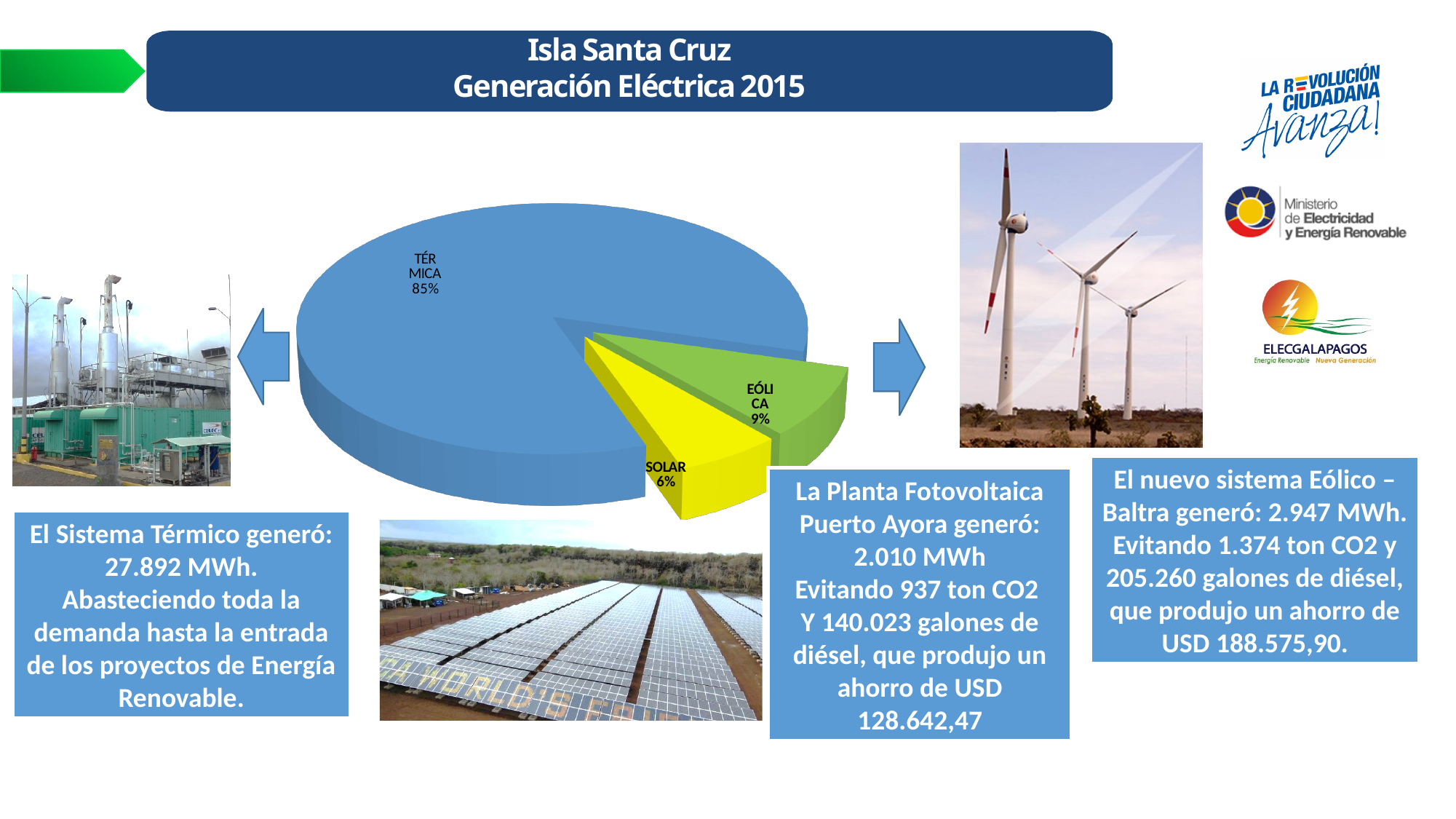
What colour is the SOLAR slice of the pie chart? yellow What share of the pie does EÓLICA represent? 9% What kind of chart is shown on the slide? pie chart What share of the pie does TÉRMICA represent? 85% What is the difference in percentage points between the TÉRMICA and EÓLICA slices? 76 Which slice of the pie chart is the largest? TÉRMICA Which slice of the pie chart is the smallest? SOLAR What colour is the EÓLICA slice of the pie chart? green How many slices does the pie chart have? 3 What share of the pie does SOLAR represent? 6% What is the difference in percentage points between the EÓLICA and SOLAR slices? 3 Which is larger in the pie chart, EÓLICA or SOLAR? EÓLICA